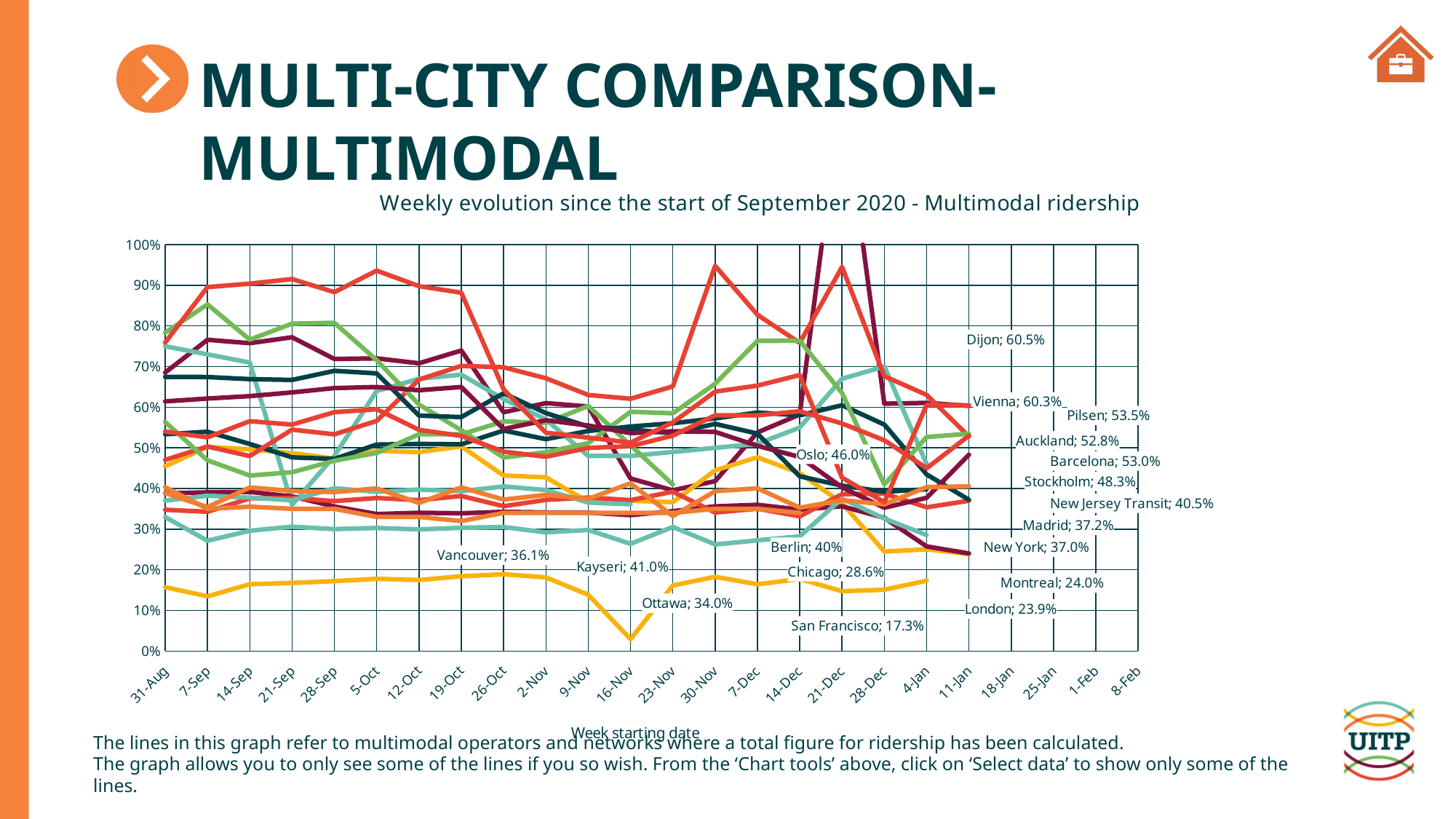
What is the x-axis title of the chart? Week starting date Which city has the lowest labelled value on the chart? San Francisco What value is labelled for New Jersey Transit on the chart? 40.5% What is the title of the chart? Weekly evolution since the start of September 2020 - Multimodal ridership What value is labelled for San Francisco on the chart? 17.3% What value is labelled for Dijon on the chart? 60.5% Which city has the highest labelled value on the chart? Dijon What kind of chart is shown on the slide? line chart What is the difference between the labelled values for Dijon and Vienna? 0.2% Which has the larger labelled value, Pilsen or Barcelona? Pilsen What value is labelled for Kayseri on the chart? 41.0% How many week starting dates are shown on the x axis? 24